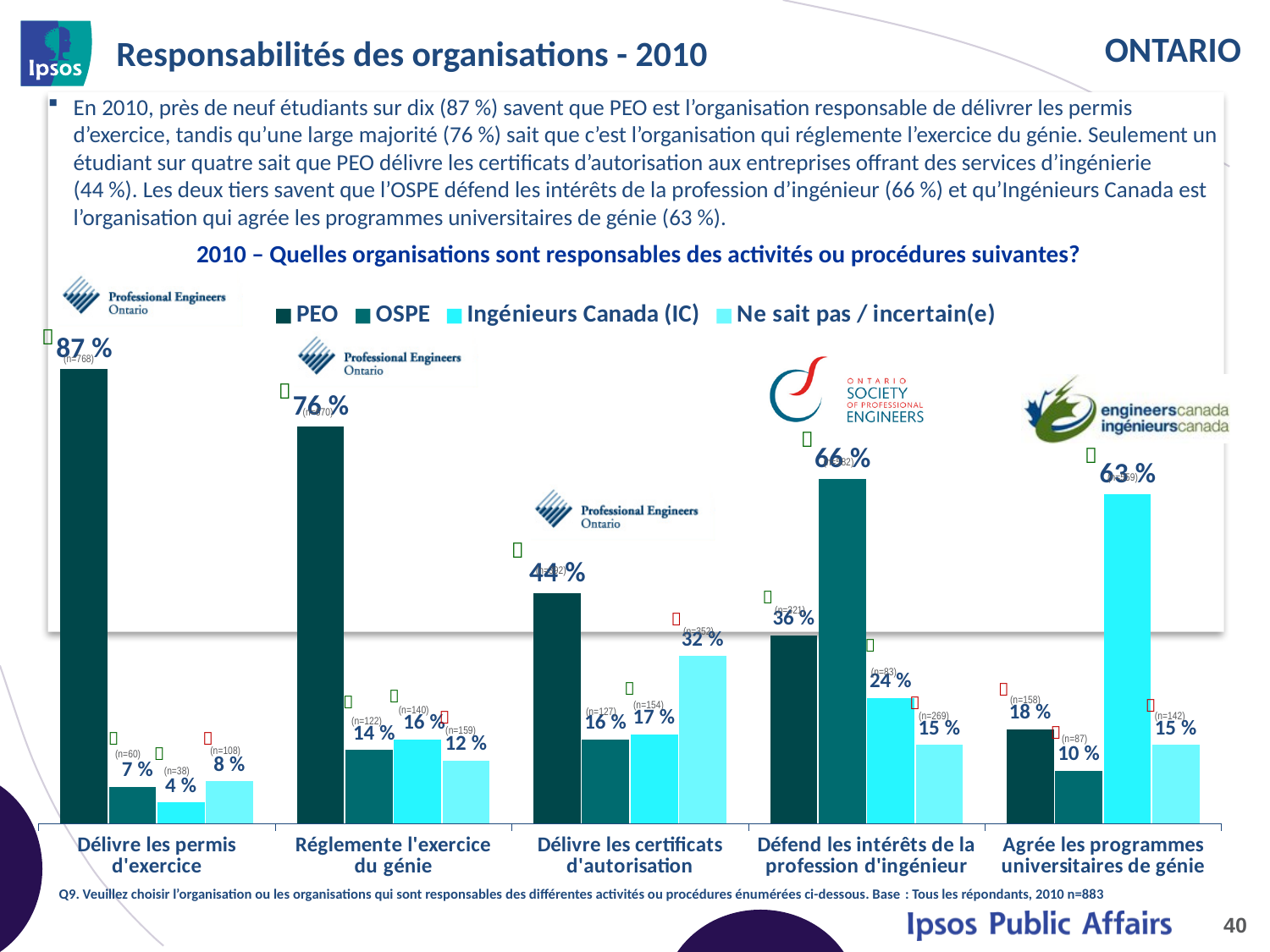
What kind of chart is shown on the slide? Bar chart What is the "Ne sait pas / incertain(e)" value for "Délivre les certificats d'autorisation"? 32 % How many series does the chart legend list? 4 What is the difference between the PEO values for "Délivre les permis d'exercice" and "Réglemente l'exercice du génie"? 11 % What is the OSPE value for "Défend les intérêts de la profession d'ingénieur"? 66 % Which category has the highest PEO value? Délivre les permis d'exercice What is the Ingénieurs Canada (IC) value for "Agrée les programmes universitaires de génie"? 63 % For "Défend les intérêts de la profession d'ingénieur", which is larger: the PEO value or the OSPE value? OSPE What is the title of the chart? 2010 – Quelles organisations sont responsables des activités ou procédures suivantes? Which category has the lowest Ingénieurs Canada (IC) value? Délivre les permis d'exercice What is the PEO value for "Délivre les permis d'exercice"? 87 % How many categories are shown on the x axis of the chart? 5